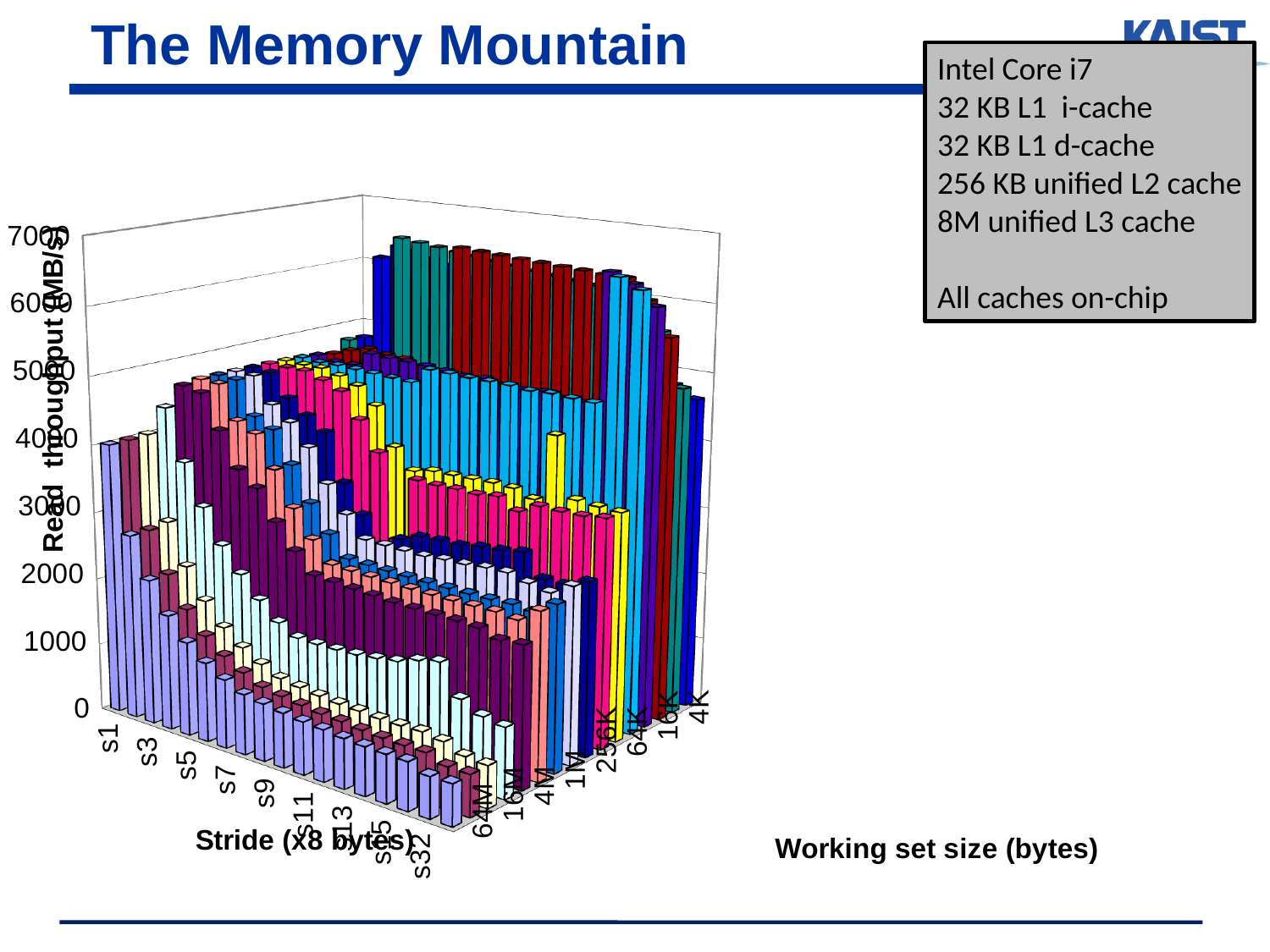
For a working set size of 64M, is the read throughput at stride s32 greater or less than 2000 MB/s? less For a working set size of 64M, does the read throughput rise or fall as the stride increases from s1 to s32? fall For a working set size of 64M, which is larger: the read throughput at stride s1 or at stride s32? s1 What is the title of the vertical axis of the chart? Read throughput (MB/s) What is the label of the depth axis of the chart? Working set size (bytes) Which working set size gives higher read throughput at stride s1: 4K or 64M? 4K How many working set size labels are shown on the depth axis of the chart? 8 What kind of chart is shown on the slide? bar chart For a working set size of 64M, which stride gives the highest read throughput? s1